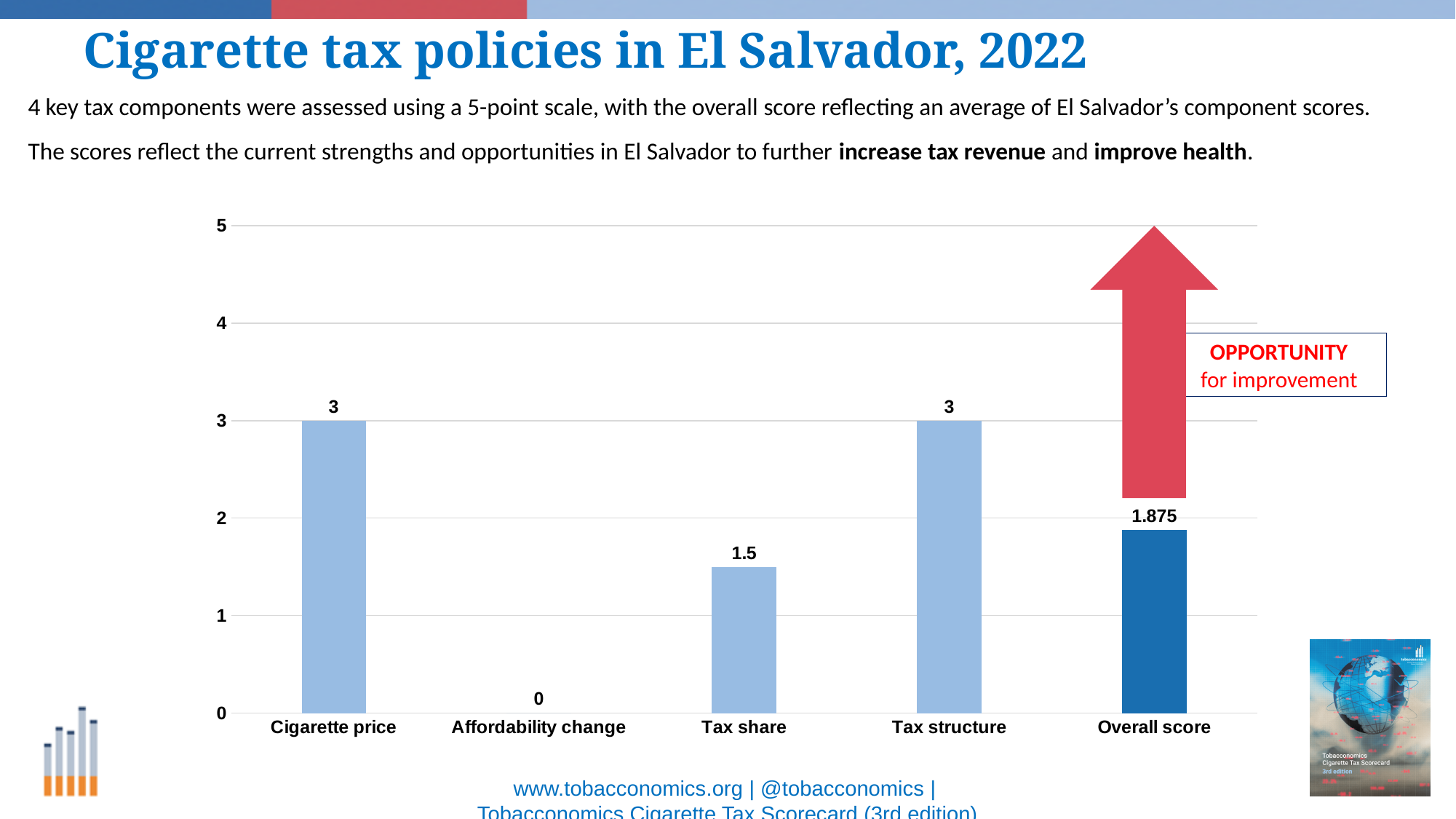
What is the highest value shown on the y axis? 5 Which is larger, the value for Tax share or the Overall score? Overall score How many categories are shown on the x axis? 5 What kind of chart is shown on the slide? bar chart What does the red arrow above the Overall score bar indicate? OPPORTUNITY for improvement What is the value for Cigarette price? 3 What is the value for Affordability change? 0 What is the difference between the Tax structure value and the Tax share value? 1.5 What is the value for Tax share? 1.5 Is the Overall score greater or less than 2? less What is the Overall score? 1.875 Which category has the lowest value? Affordability change